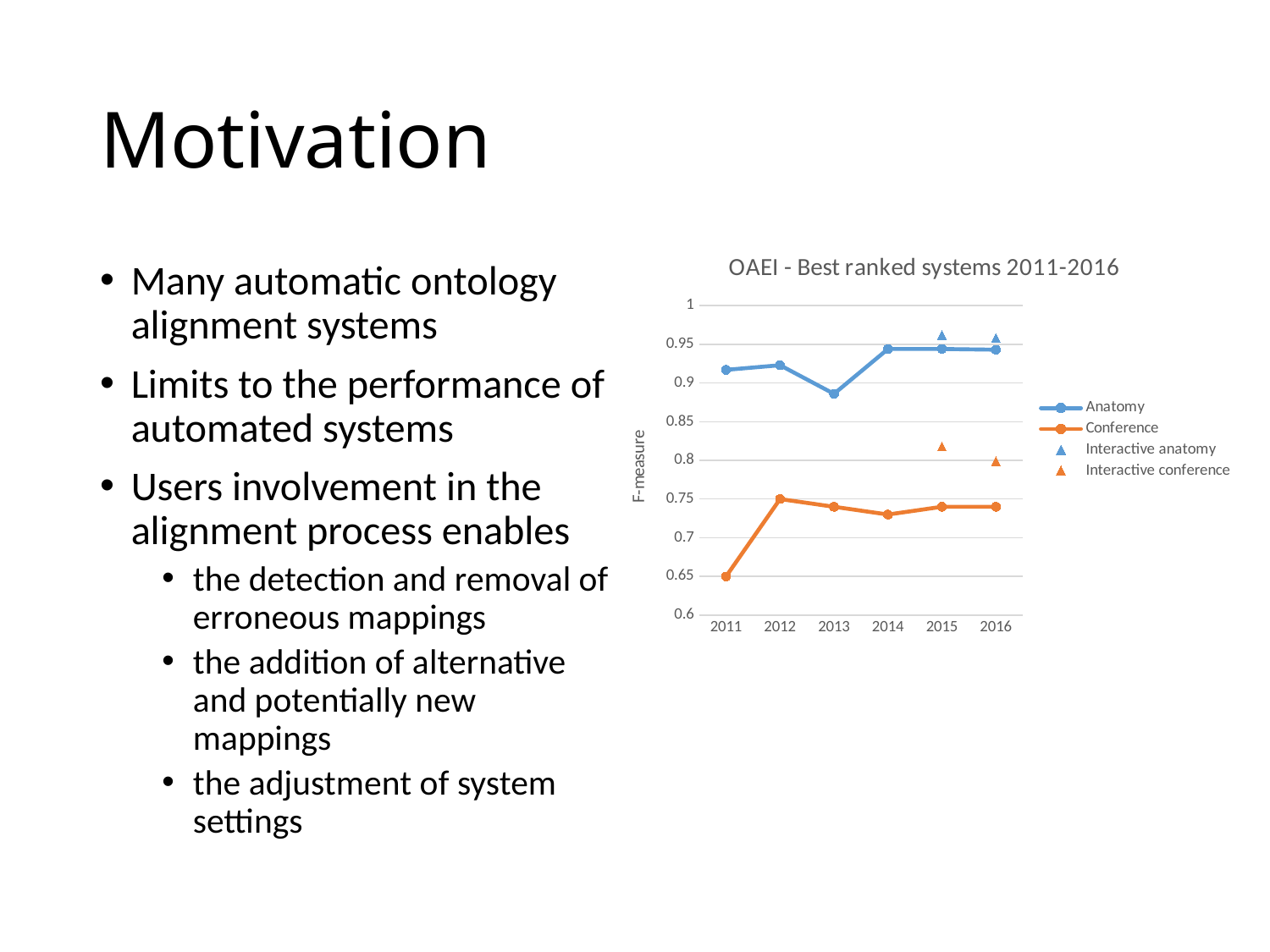
Is the Conference value for 2011 greater or less than 0.7? less In which year is the Anatomy series at its lowest value? 2013 Is the Anatomy value for 2013 greater or less than 0.9? less What is the title of the chart on the slide? OAEI - Best ranked systems 2011-2016 What is the label of the y axis of the chart? F-measure How many series does the chart legend list? 4 Is the Interactive conference value for 2015 greater or less than 0.8? greater In which year is the Conference series at its lowest value? 2011 Does the Conference series rise or fall from 2011 to 2012? rise Which series has the larger value in 2013, Anatomy or Conference? Anatomy What kind of chart is shown on the slide? line chart How many years are shown on the x axis of the chart? 6